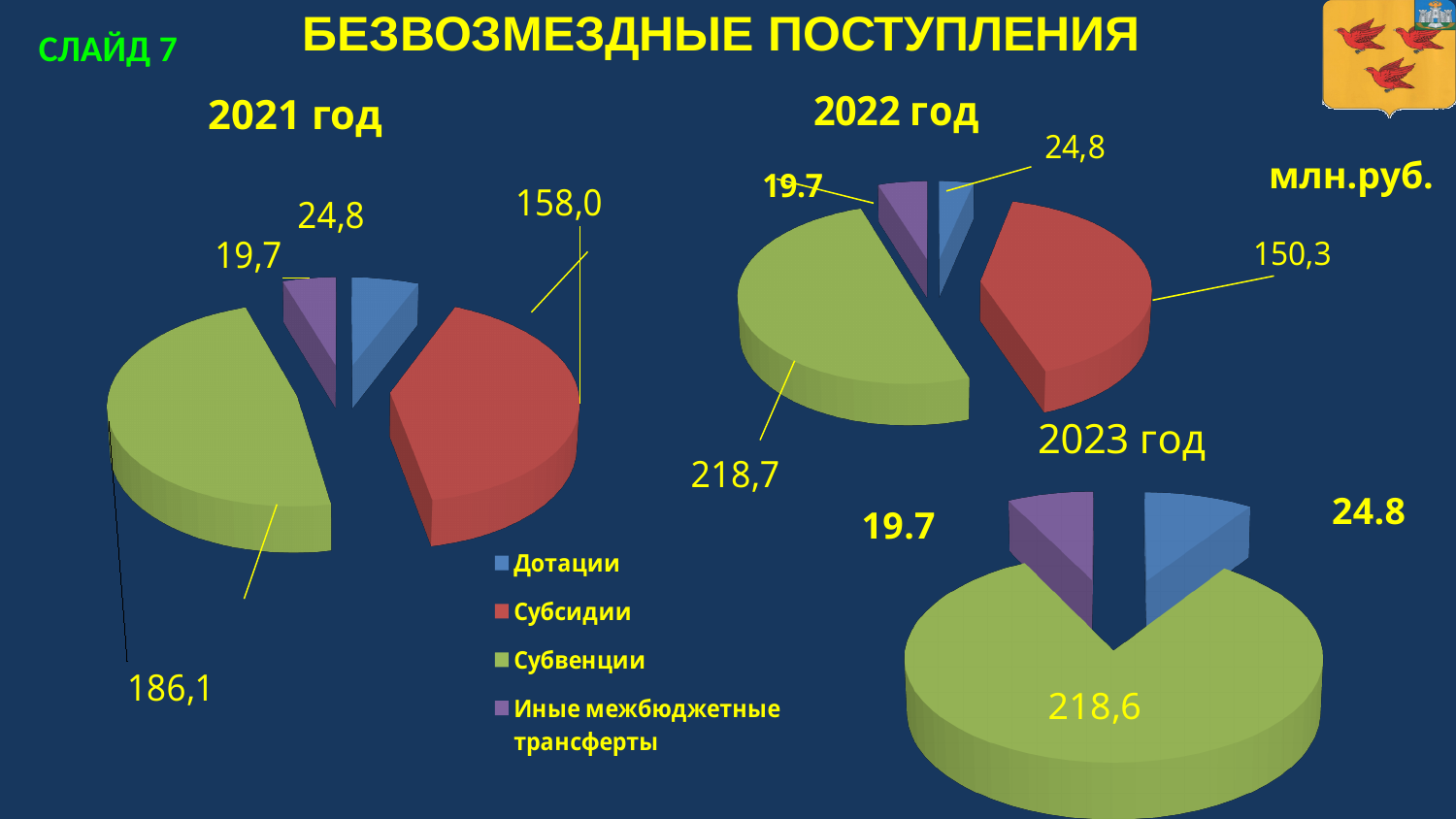
How many categories does the legend list? 4 In the 2023 год pie chart, what is the value for Субвенции? 218,6 In the 2022 год pie chart, which is larger, Субсидии or Субвенции? Субвенции In the 2022 год pie chart, what is the value for Субсидии? 150,3 In the 2021 год pie chart, which category has the largest slice? Субвенции In the 2021 год pie chart, what is the value for Субсидии? 158,0 In the 2021 год pie chart, what is the value for Субвенции? 186,1 What type of chart is used for 2021 год? Pie chart In the 2021 год pie chart, what is the difference between Субвенции and Субсидии? 28,1 How many slices does the 2023 год pie chart have? 3 In the 2022 год pie chart, what is the value for Субвенции? 218,7